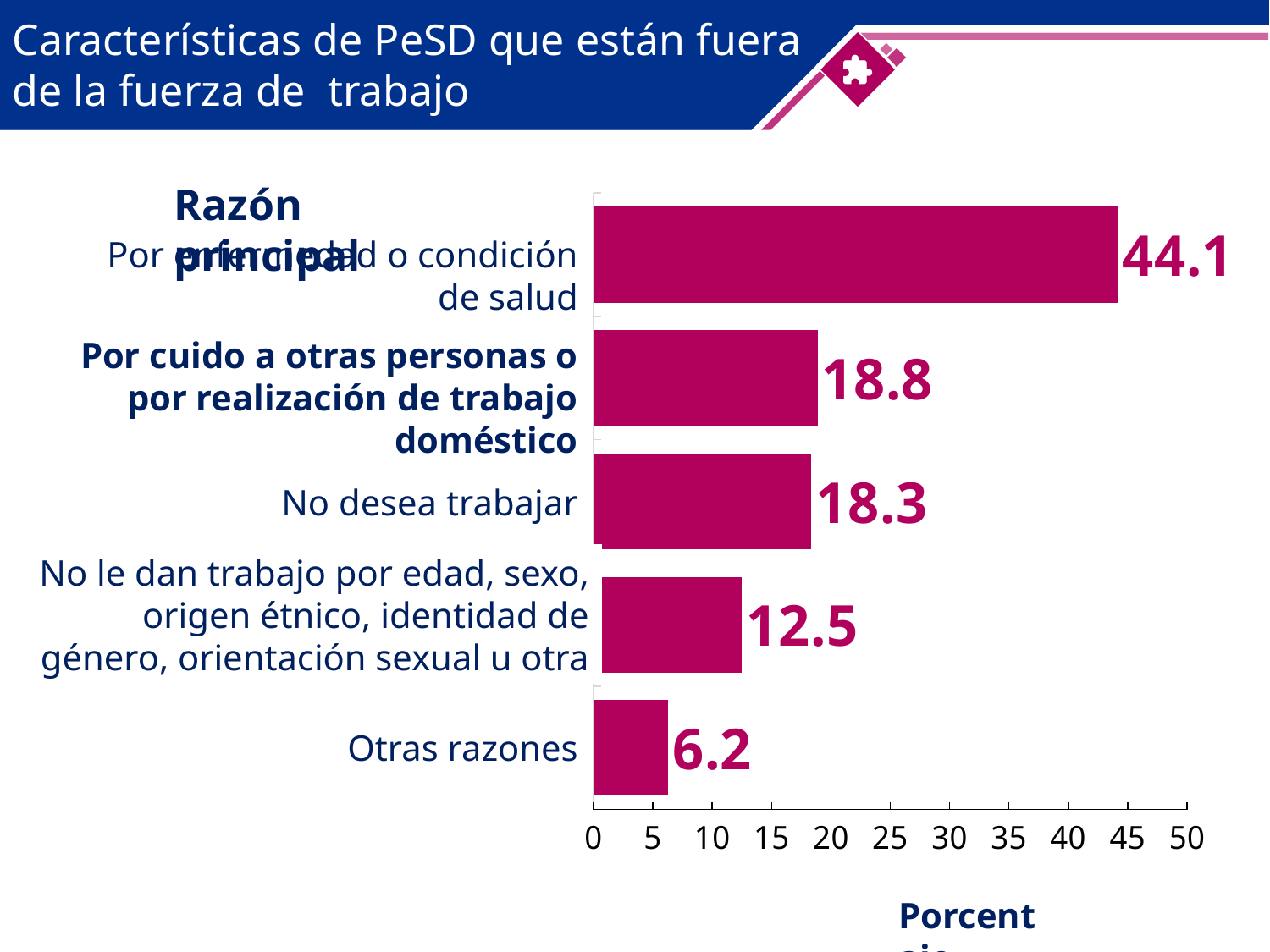
What is the value for "Por enfermedad o condición de salud"? 44.1 What is the difference between the values for "Por enfermedad o condición de salud" and "Otras razones"? 37.9 Which category has the highest value? Por enfermedad o condición de salud What is the value for "Por cuido a otras personas o por realización de trabajo doméstico"? 18.8 What is the value for "Otras razones"? 6.2 What kind of chart is shown on the slide? bar chart Which category has the lowest value? Otras razones What is the value for "No le dan trabajo por edad, sexo, origen étnico, identidad de género, orientación sexual u otra"? 12.5 Which is larger, the value for "No desea trabajar" or the value for "Otras razones"? No desea trabajar How many categories are shown in the chart? 5 What is the difference between the values for "Por cuido a otras personas o por realización de trabajo doméstico" and "No desea trabajar"? 0.5 What is the value for "No desea trabajar"? 18.3